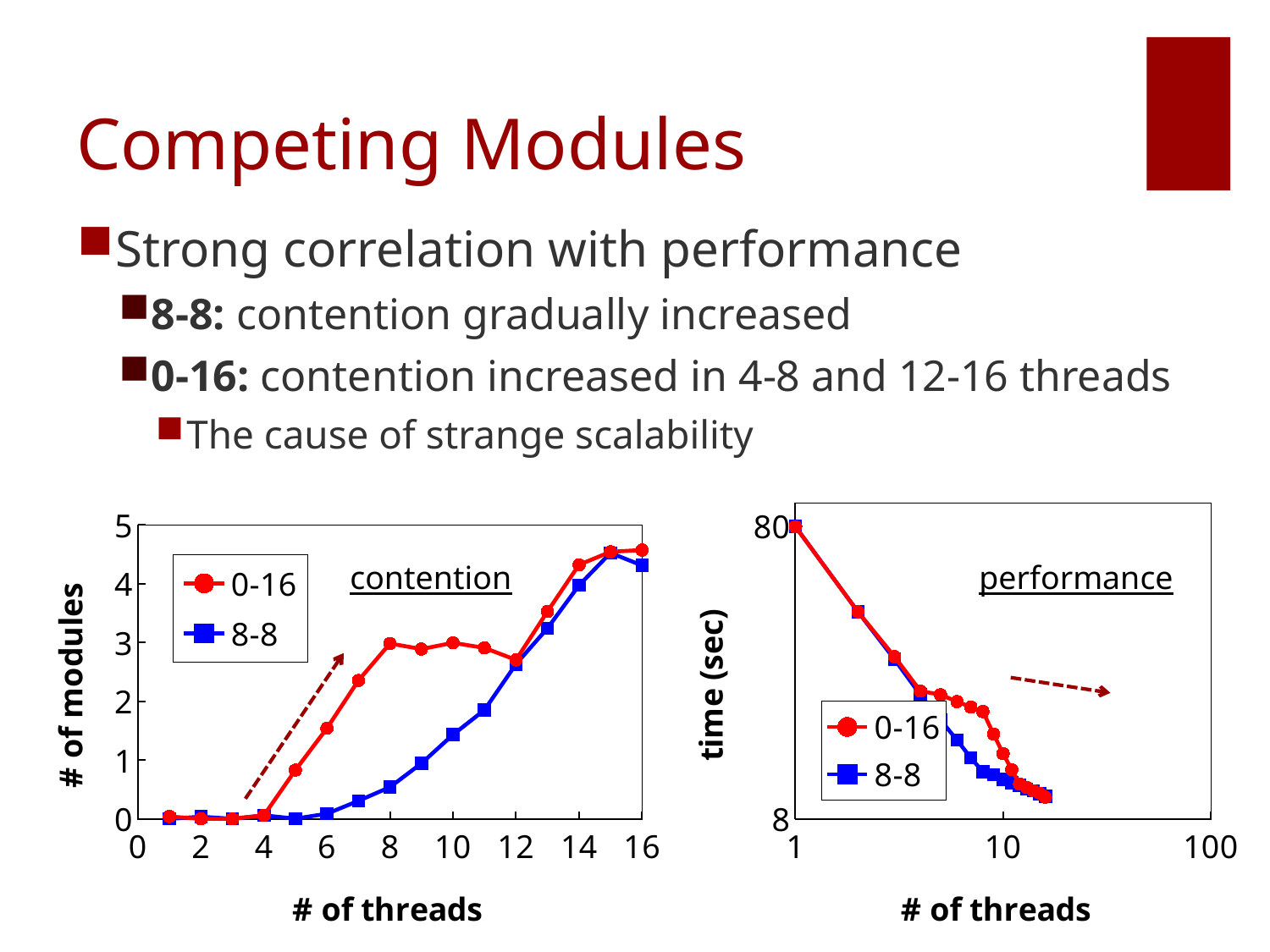
How many data points does each series have in the left "contention" chart? 16 What kind of chart is the right chart labelled "performance"? line chart In the right "performance" chart, does the time (sec) rise or fall as the # of threads increases? fall What kind of chart is the left chart labelled "contention"? line chart How many series does the legend of the left "contention" chart list? 2 In the left "contention" chart, is the value for 0-16 at 8 threads greater or less than 2? greater In the left "contention" chart, does the 8-8 series generally rise or fall as the # of threads increases? rise In the left "contention" chart, is the value for 8-8 at 8 threads greater or less than 1? less What are the two series names in the legend of the left "contention" chart? 0-16 and 8-8 In the left "contention" chart, which series has the higher # of modules at 8 threads, 0-16 or 8-8? 0-16